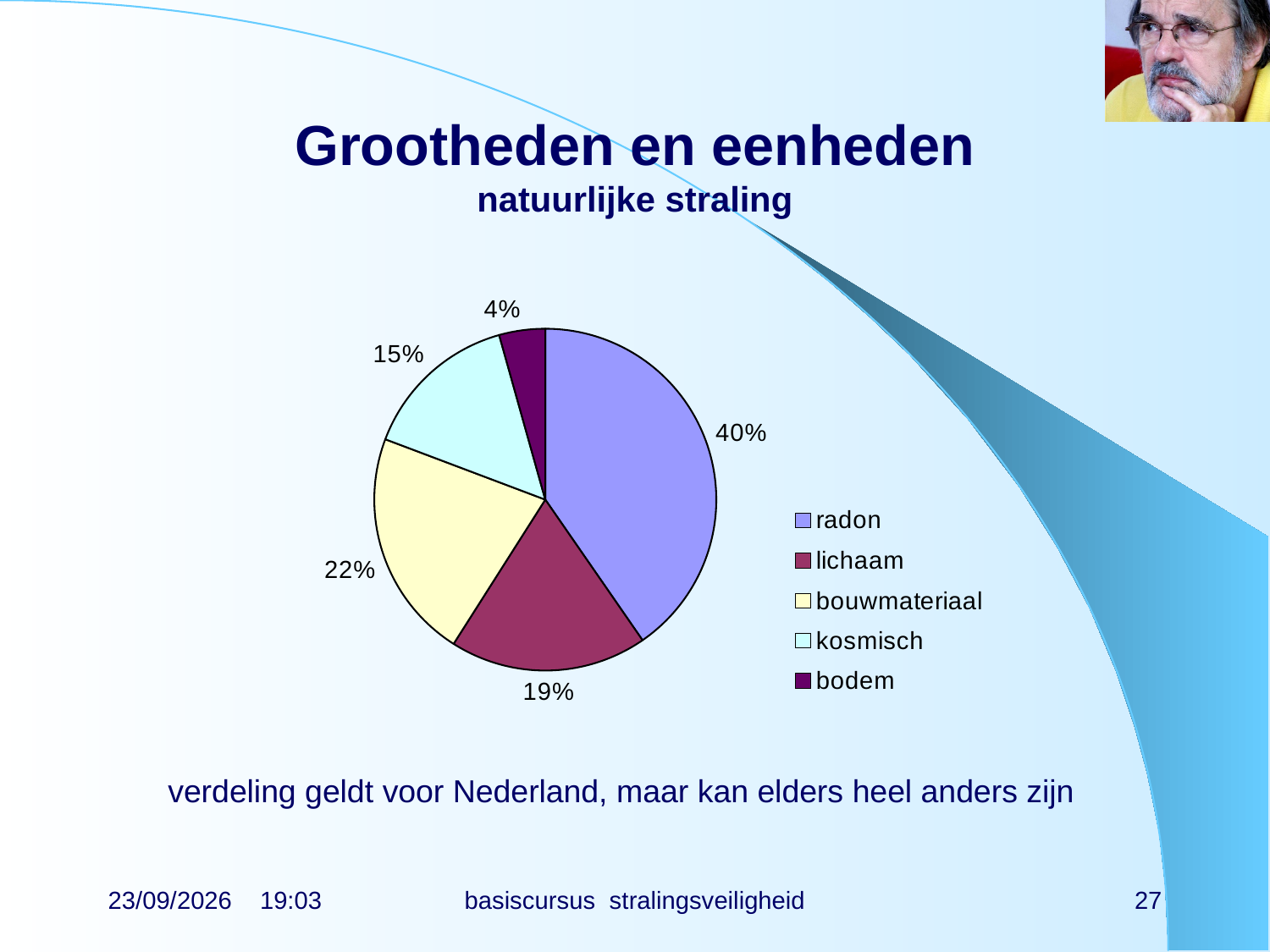
What share of the pie does lichaam have? 19% Which category has the smallest slice of the pie? bodem What is the subtitle shown above the chart? natuurlijke straling What kind of chart is shown on the slide? pie chart What share of the pie does bodem have? 4% Which is larger, the share for bouwmateriaal or the share for lichaam? bouwmateriaal What share of the pie does radon have? 40% Which category has the largest slice of the pie? radon How many categories does the legend list? 5 What is the difference in percentage points between radon and bouwmateriaal? 18